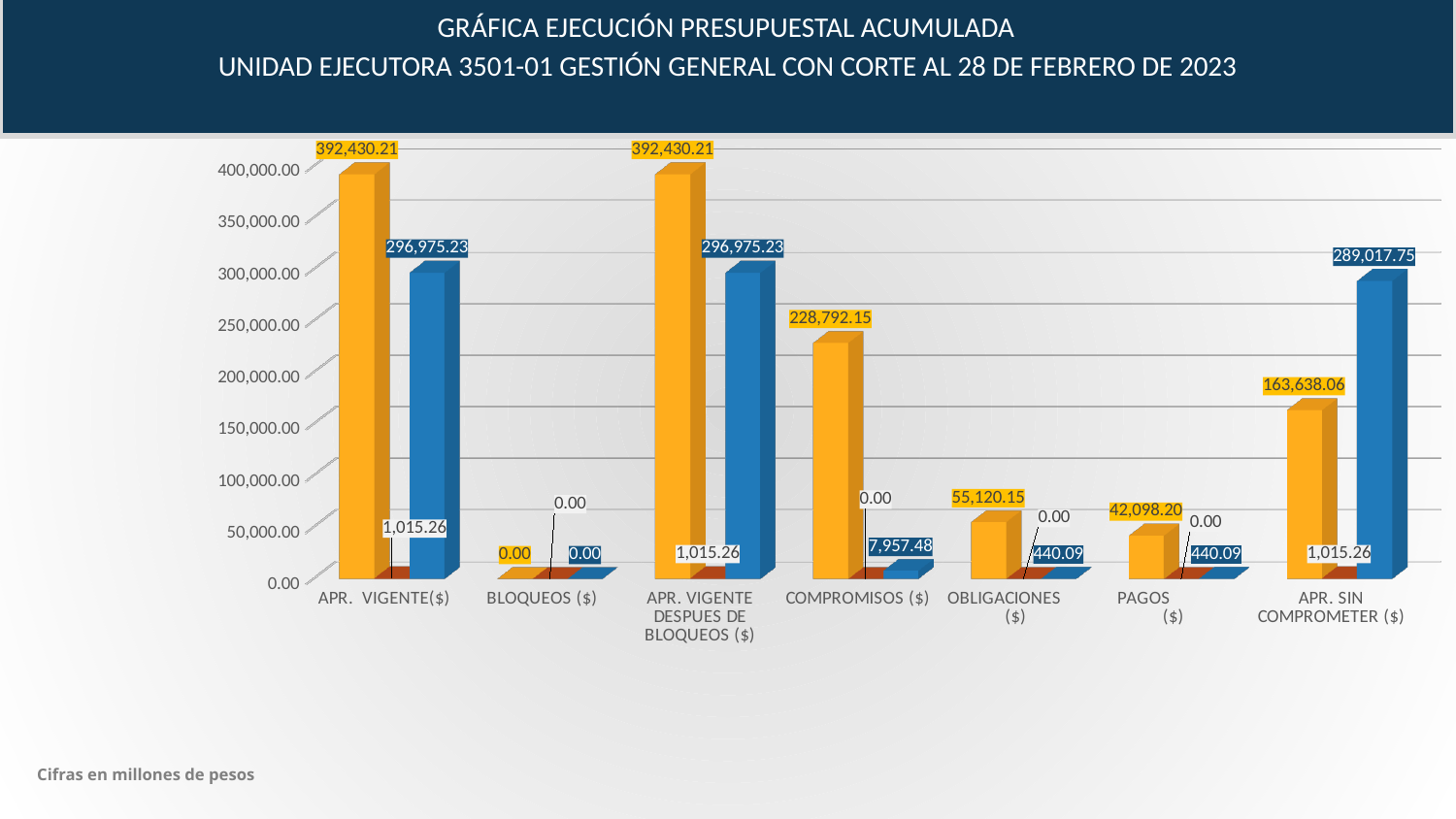
What is the value of the blue bar for APR. SIN COMPROMETER ($)? 289,017.75 What kind of chart is shown on the slide? bar chart What unit note is printed at the bottom left of the slide? Cifras en millones de pesos Which category has the highest orange bar? APR. VIGENTE($) and APR. VIGENTE DESPUES DE BLOQUEOS ($) Is the orange bar for APR. SIN COMPROMETER ($) greater or less than 150,000.00? greater What is the value of the blue bar for OBLIGACIONES ($)? 440.09 What is the value of the orange bar for PAGOS ($)? 42,098.20 Which category has the lowest blue bar? BLOQUEOS ($) How many categories are shown on the x axis? 7 What is the value of the orange bar for COMPROMISOS ($)? 228,792.15 What is the difference between the orange bar for APR. VIGENTE($) and the blue bar for APR. VIGENTE($)? 95,454.98 Which is larger: the orange bar for OBLIGACIONES ($) or the orange bar for PAGOS ($)? OBLIGACIONES ($)